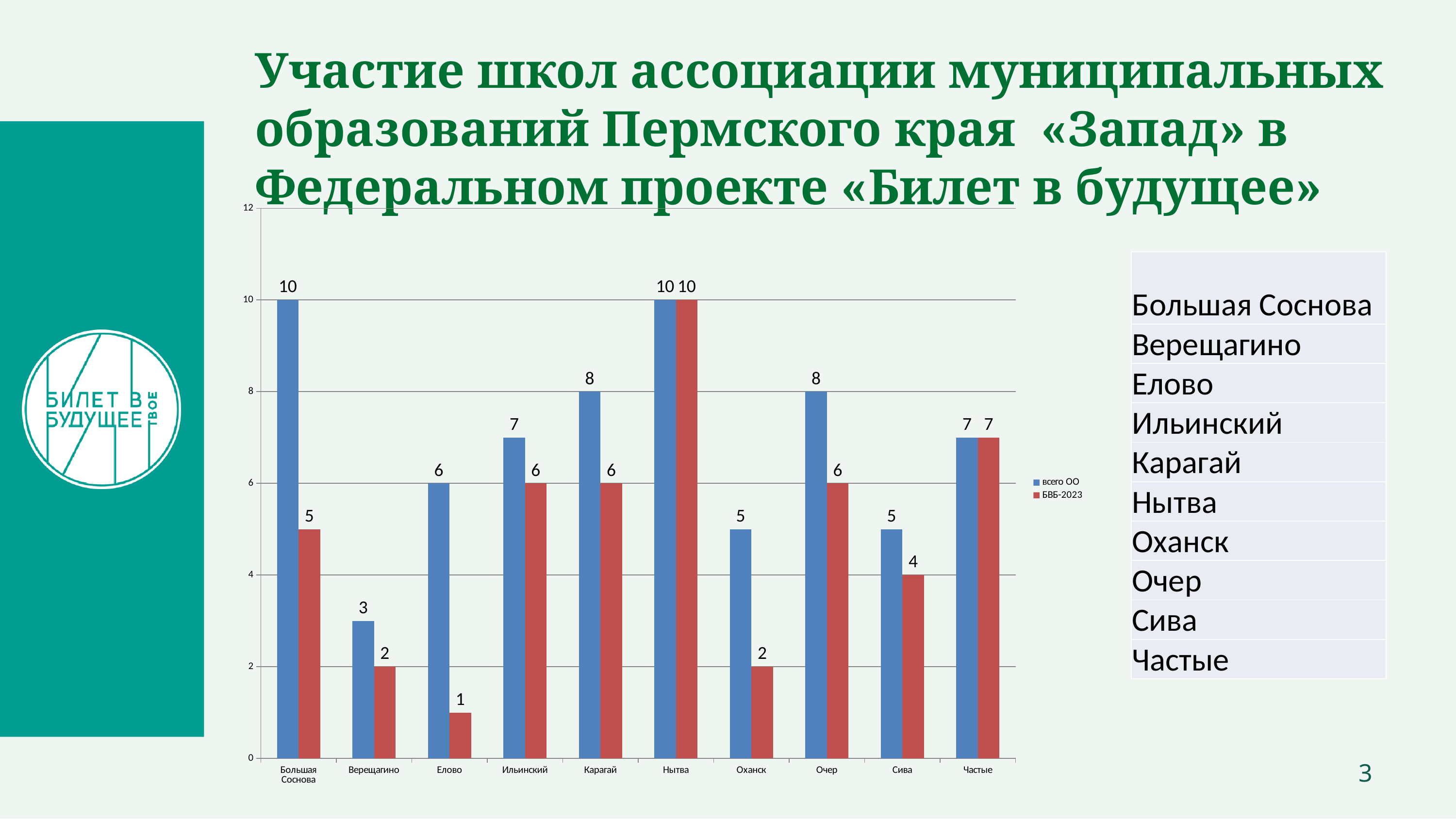
What is the difference between 'всего ОО' and 'БВБ-2023' for Оханск? 3 Which category has the lowest 'всего ОО' value? Верещагино What is the difference between 'всего ОО' and 'БВБ-2023' for Большая Соснова? 5 What kind of chart is shown on the slide? bar chart What is the value of 'БВБ-2023' for Сива? 4 Which colour represents the 'БВБ-2023' series? red How many categories are shown on the x axis? 10 How many series does the legend list? 2 What is the value of 'всего ОО' for Большая Соснова? 10 Which category has the lowest 'БВБ-2023' value? Елово What is the value of 'БВБ-2023' for Елово? 1 Which is larger: 'всего ОО' for Карагай or 'всего ОО' for Ильинский? Карагай